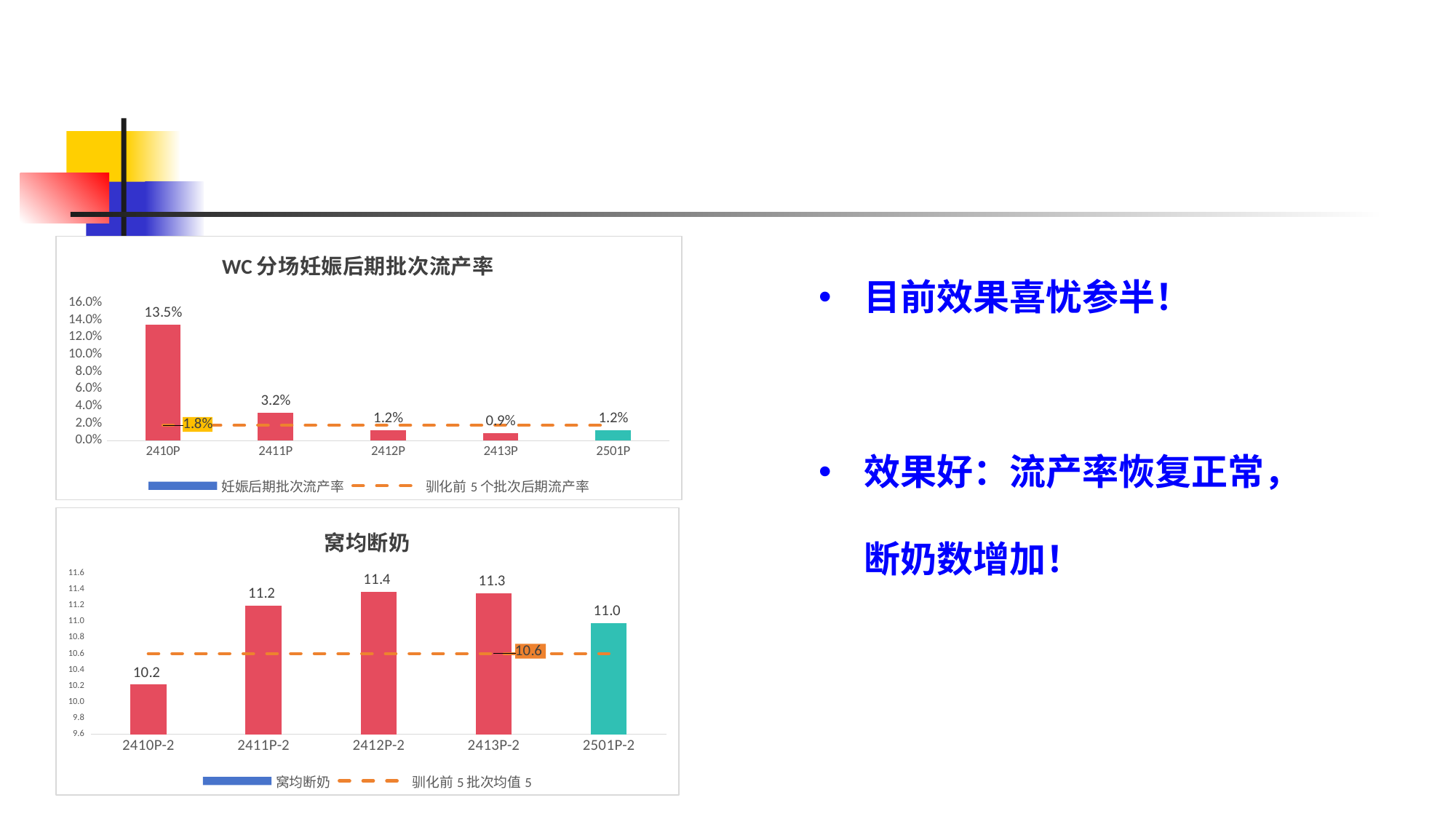
In the chart titled "WC 分场妊娠后期批次流产率", what is the value for 2410P? 13.5% In the chart titled "窝均断奶", what is the difference between the values for 2412P-2 and 2410P-2? 1.2 In the chart titled "窝均断奶", which category has the highest value? 2412P-2 What kind of chart is the chart titled "窝均断奶"? combination bar and line chart In the chart titled "WC 分场妊娠后期批次流产率", what is the difference between the values for 2410P and 2411P? 10.3% In the chart titled "WC 分场妊娠后期批次流产率", which category has the lowest value? 2413P In the chart titled "WC 分场妊娠后期批次流产率", how many categories are shown on the x axis? 5 In the chart titled "窝均断奶", how many entries does the legend list? 2 In the chart titled "窝均断奶", which is larger, the value for 2411P-2 or the value for 2410P-2? 2411P-2 In the chart titled "WC 分场妊娠后期批次流产率", do the bar values generally rise or fall from 2410P to 2413P? fall In the chart titled "WC 分场妊娠后期批次流产率", what value does the dashed reference line show? 1.8% In the chart titled "窝均断奶", what is the value for 2501P-2? 11.0